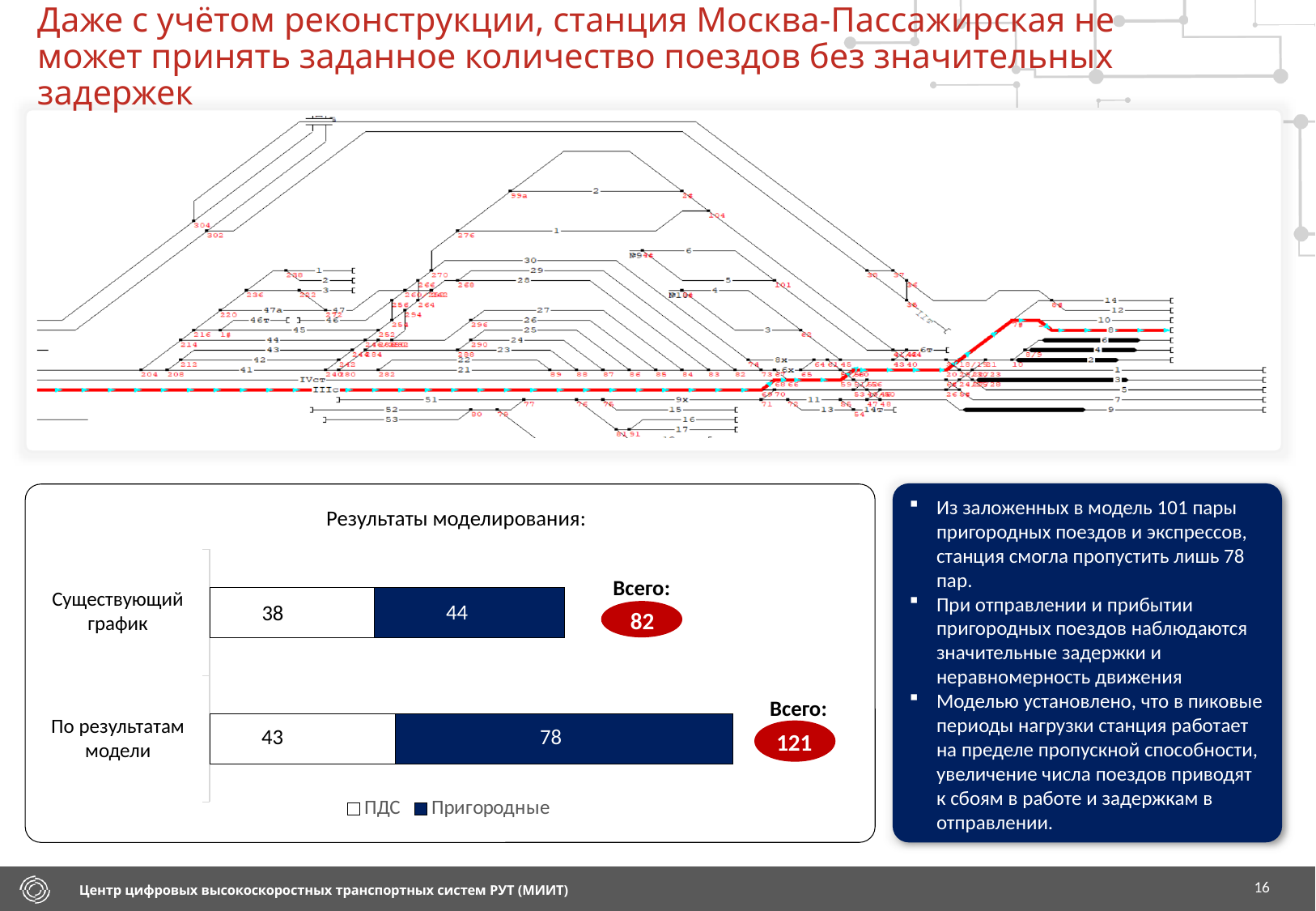
What kind of chart is shown under the title Результаты моделирования? Stacked bar chart What is the total of the По результатам модели stacked bar? 121 What is the difference between the Пригородные values for По результатам модели and Существующий график? 34 How many categories are shown in the chart? 2 What is the value for ПДС in the По результатам модели bar? 43 What is the value for Пригородные in the Существующий график bar? 44 Which category has the higher Пригородные value, Существующий график or По результатам модели? По результатам модели What is the value for ПДС in the Существующий график bar? 38 What is the value for Пригородные in the По результатам модели bar? 78 How many series does the legend list? 2 What is the total of the Существующий график stacked bar? 82 What is the title of the chart? Результаты моделирования: